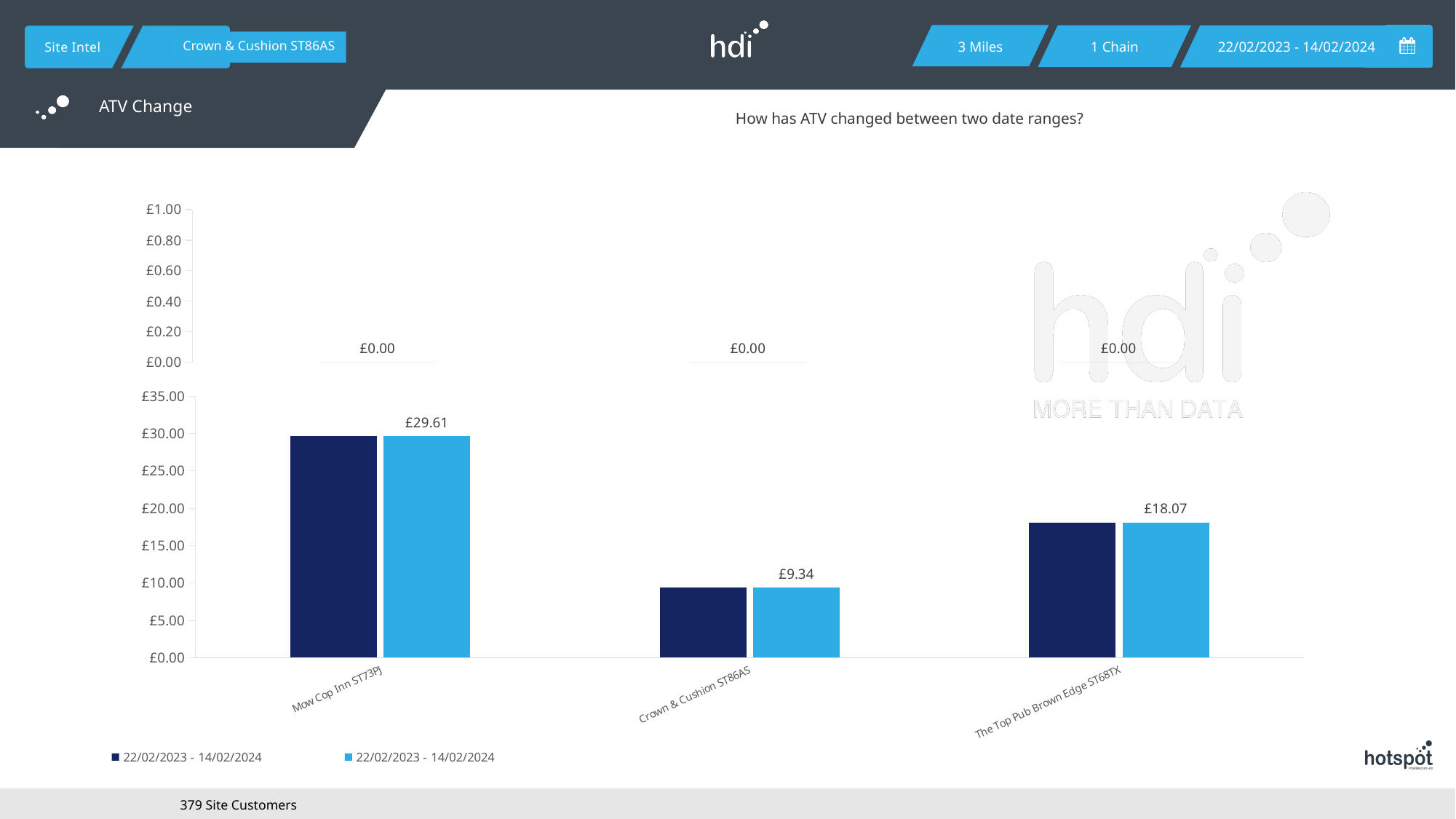
Which has a larger labelled ATV value, Crown & Cushion ST86AS or The Top Pub Brown Edge ST68TX? The Top Pub Brown Edge ST68TX How many site categories are shown on the x axis of the chart? 3 What kind of chart is shown on the slide? bar chart Which site has the lowest labelled ATV value? Crown & Cushion ST86AS What is the difference between the labelled ATV values for Mow Cop Inn ST73PJ and The Top Pub Brown Edge ST68TX? £11.54 What question is posed as the chart's heading? How has ATV changed between two date ranges? What is the ATV value labelled for Mow Cop Inn ST73PJ? £29.61 What is the ATV value labelled for Crown & Cushion ST86AS? £9.34 Which site has the highest labelled ATV value? Mow Cop Inn ST73PJ What ATV change value is shown in the upper panel for Crown & Cushion ST86AS? £0.00 What is the ATV value labelled for The Top Pub Brown Edge ST68TX? £18.07 How many series does the chart legend list? 2